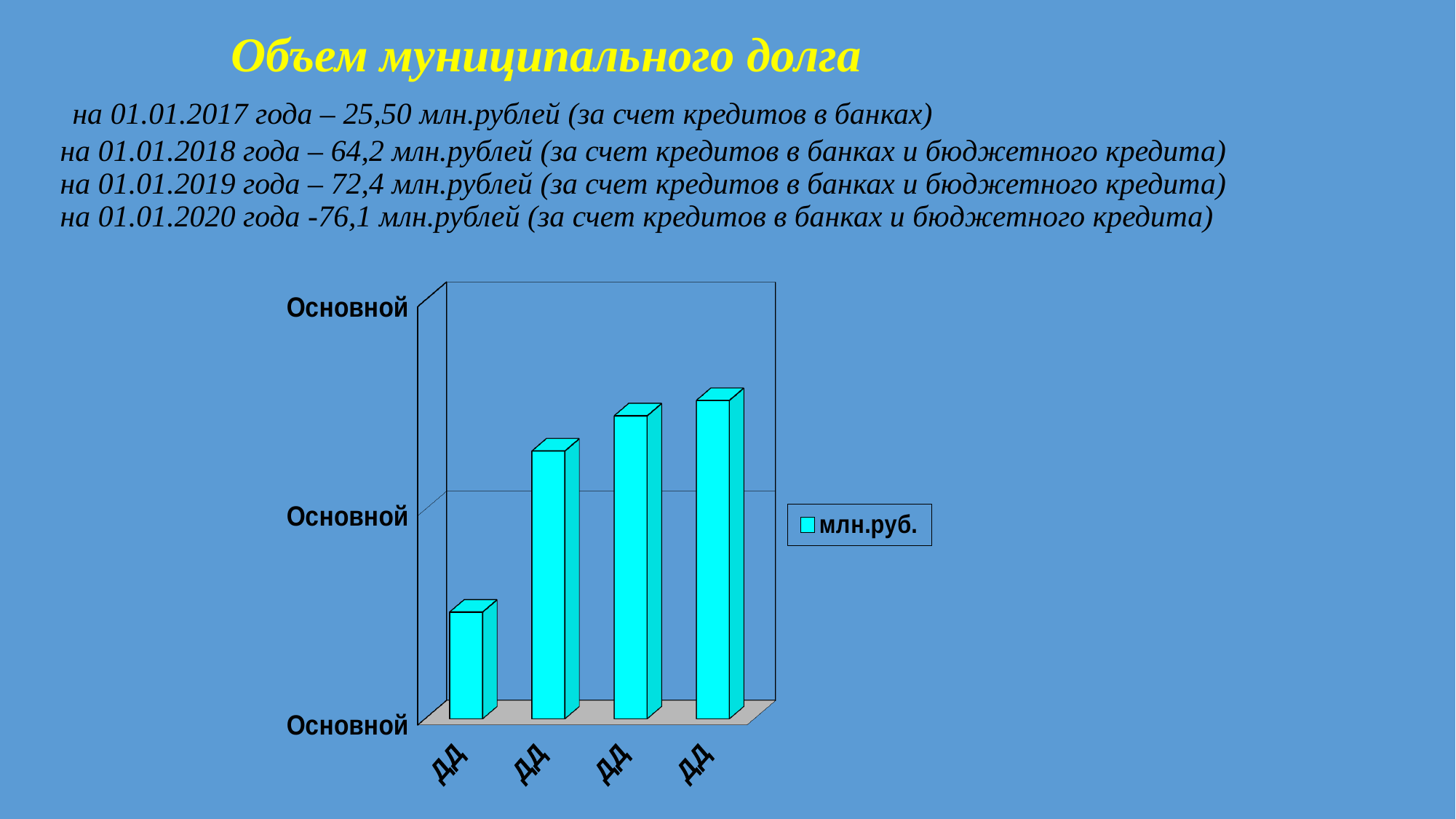
How many series does the chart legend list? 1 What is the title shown above the chart on the slide? Объем муниципального долга What kind of chart is shown on the slide? bar chart Which is larger, the first bar or the second bar? the second bar How many bars are plotted in the chart? 4 Which bar is the tallest in the chart? the fourth (rightmost) bar What is the legend entry of the chart? млн.руб. Which bar is the shortest in the chart? the first (leftmost) bar Do the bar values rise or fall from left to right along the x axis? rise Which is larger, the third bar or the fourth bar? the fourth bar